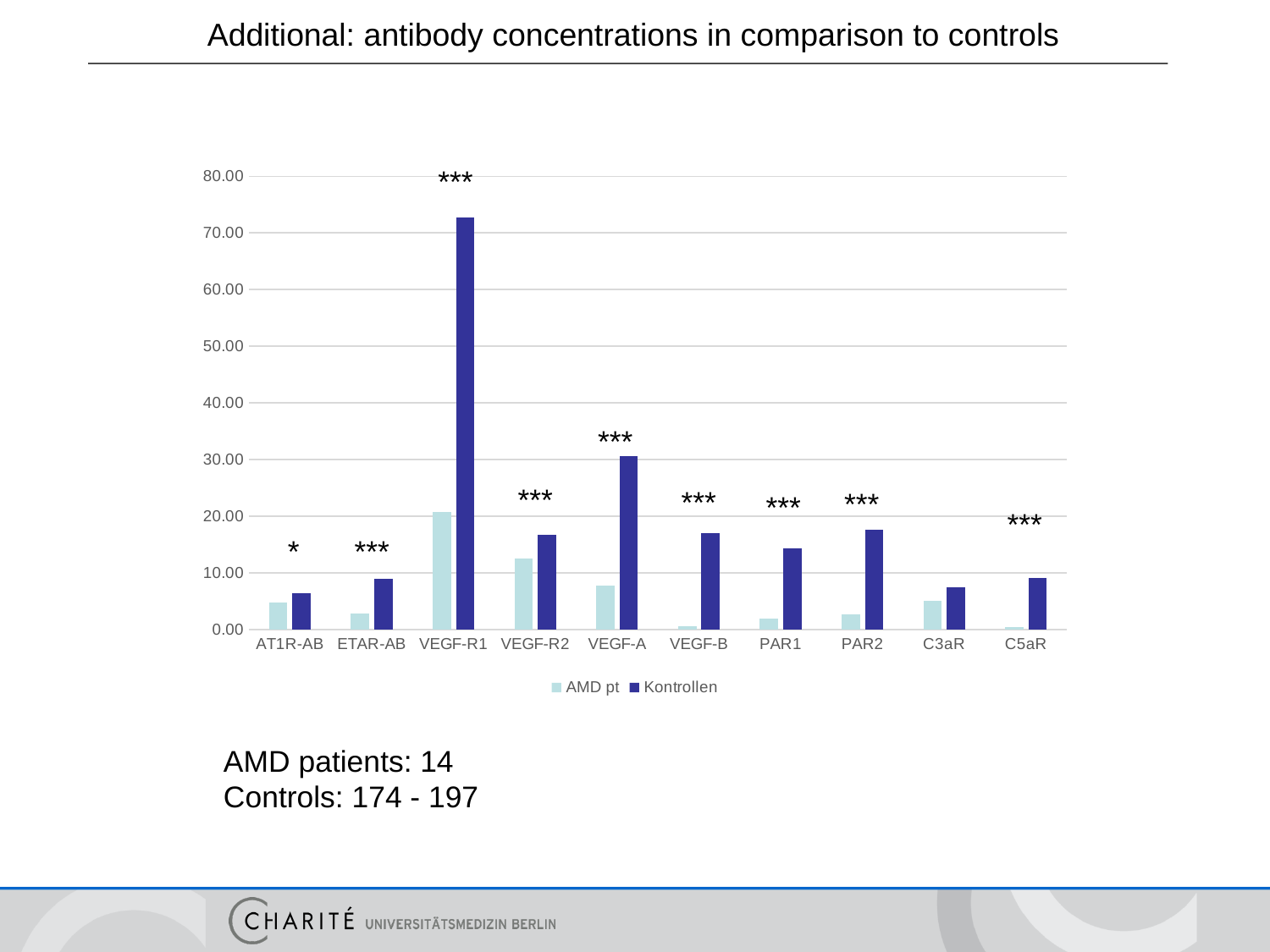
For C3aR, which series has the larger value, AMD pt or Kontrollen? Kontrollen How many series does the legend list? 2 Is the AMD pt value for VEGF-R2 greater or less than 10? greater For VEGF-A, which series has the larger value, AMD pt or Kontrollen? Kontrollen What kind of chart is shown on the slide? bar chart What are the two series names listed in the legend? AMD pt and Kontrollen Is the Kontrollen value for VEGF-R1 greater or less than 70? greater Is the Kontrollen value for PAR1 greater or less than 20? less Which category has the highest Kontrollen value? VEGF-R1 Which category has the highest AMD pt value? VEGF-R1 How many categories are shown on the x axis? 10